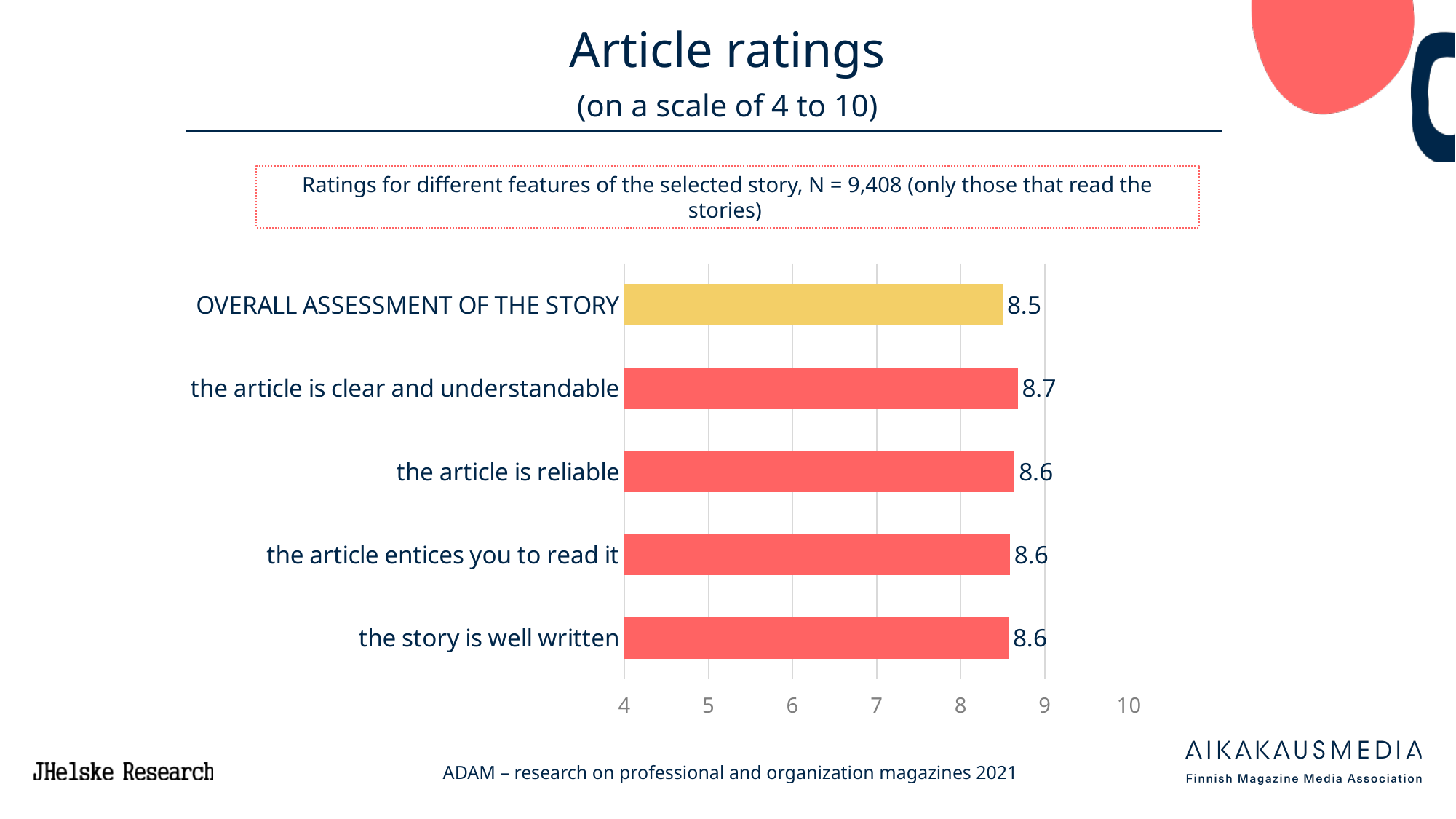
What is the rating for 'the article is reliable'? 8.6 Is the rating for 'the article is reliable' greater or less than 8? greater What is the rating for 'the article is clear and understandable'? 8.7 What kind of chart is shown on the slide? bar chart Which category has the highest rating? the article is clear and understandable What is the rating for 'OVERALL ASSESSMENT OF THE STORY'? 8.5 How many categories are shown in the chart? 5 What is the difference between the rating for 'the article is clear and understandable' and the rating for 'OVERALL ASSESSMENT OF THE STORY'? 0.2 Which category has the lowest rating? OVERALL ASSESSMENT OF THE STORY Which is larger: the rating for 'the article is clear and understandable' or the rating for 'the article entices you to read it'? the article is clear and understandable What is the rating for 'the story is well written'? 8.6 Which bar is coloured differently (yellow) from the others? OVERALL ASSESSMENT OF THE STORY